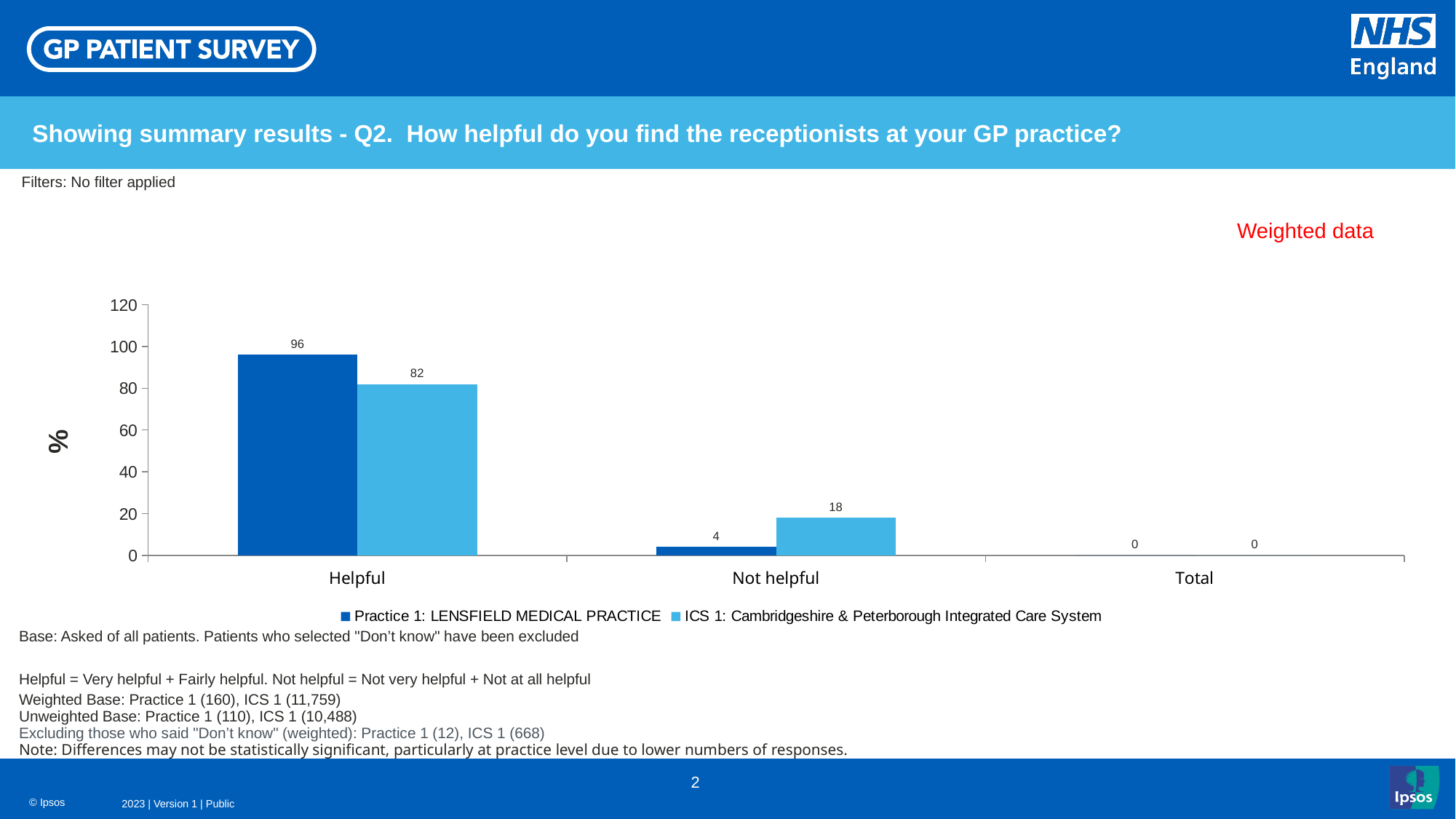
What label is shown on the vertical axis of the chart? % What is the value for ICS 1: Cambridgeshire & Peterborough Integrated Care System in the Helpful category? 82 Which category has the highest value for Practice 1: LENSFIELD MEDICAL PRACTICE? Helpful What kind of chart is shown on the slide? Bar chart What is the value for Practice 1: LENSFIELD MEDICAL PRACTICE in the Helpful category? 96 How many series does the legend list? 2 What is the value for Practice 1: LENSFIELD MEDICAL PRACTICE in the Not helpful category? 4 How many categories are shown on the x axis? 3 What is the value for ICS 1: Cambridgeshire & Peterborough Integrated Care System in the Not helpful category? 18 In the Not helpful category, which series has the larger value, Practice 1 or ICS 1? ICS 1: Cambridgeshire & Peterborough Integrated Care System What is the difference between the Practice 1 and ICS 1 values in the Helpful category? 14 What is the difference between the ICS 1 and Practice 1 values in the Not helpful category? 14